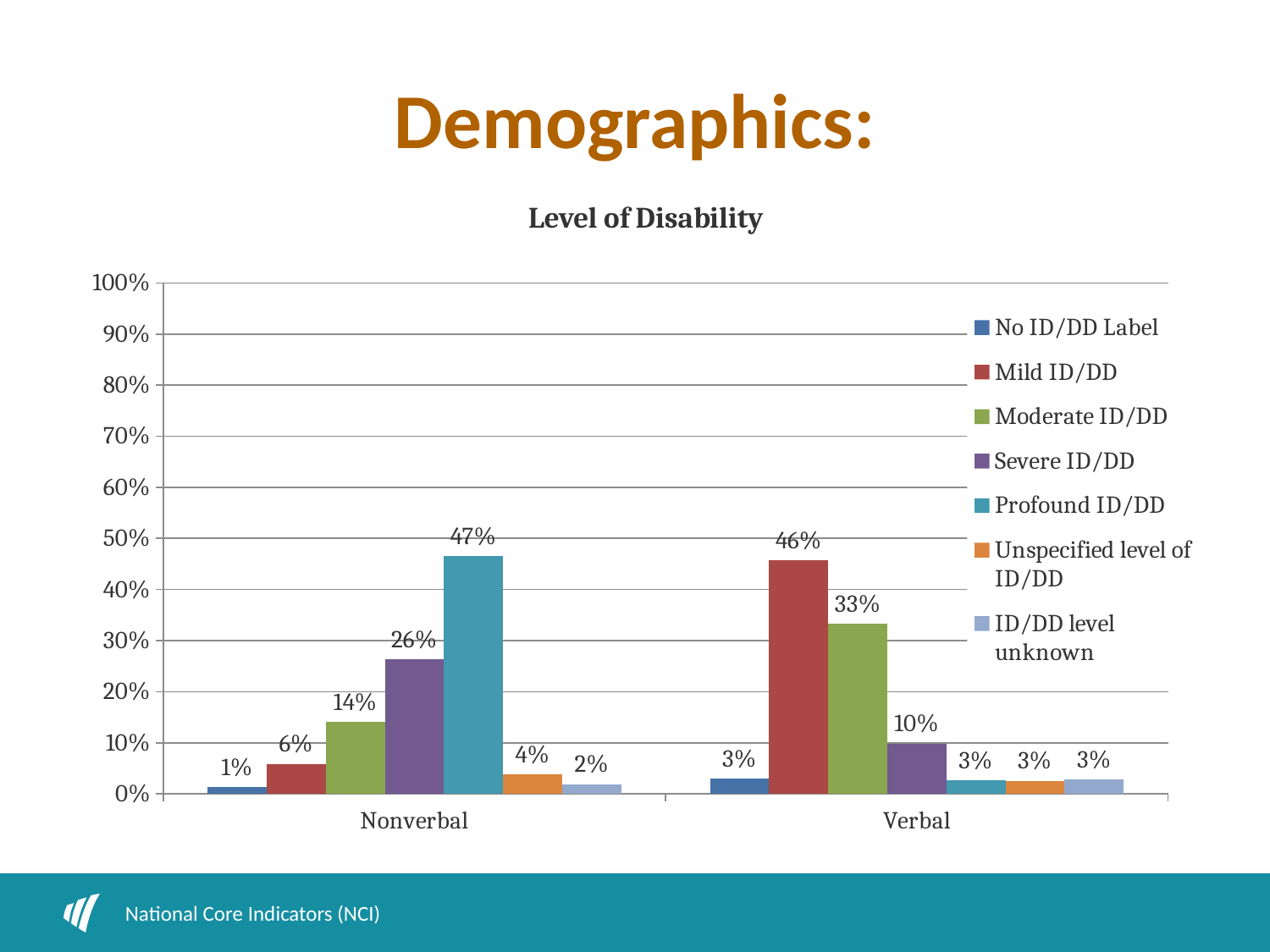
What is the title of the chart? Level of Disability What is the value for Severe ID/DD in the Verbal group? 10% What is the difference between the Severe ID/DD values for Nonverbal and Verbal? 16% What is the value for Mild ID/DD in the Verbal group? 46% Which level of disability has the highest value in the Nonverbal group? Profound ID/DD Which is larger: Moderate ID/DD for Nonverbal or Moderate ID/DD for Verbal? Moderate ID/DD for Verbal Which level of disability has the highest value in the Verbal group? Mild ID/DD What kind of chart is shown on the slide? Bar chart Which level of disability has the lowest value in the Nonverbal group? No ID/DD Label What is the value for Moderate ID/DD in the Nonverbal group? 14% What is the value for Profound ID/DD in the Nonverbal group? 47% How many series does the legend list? 7